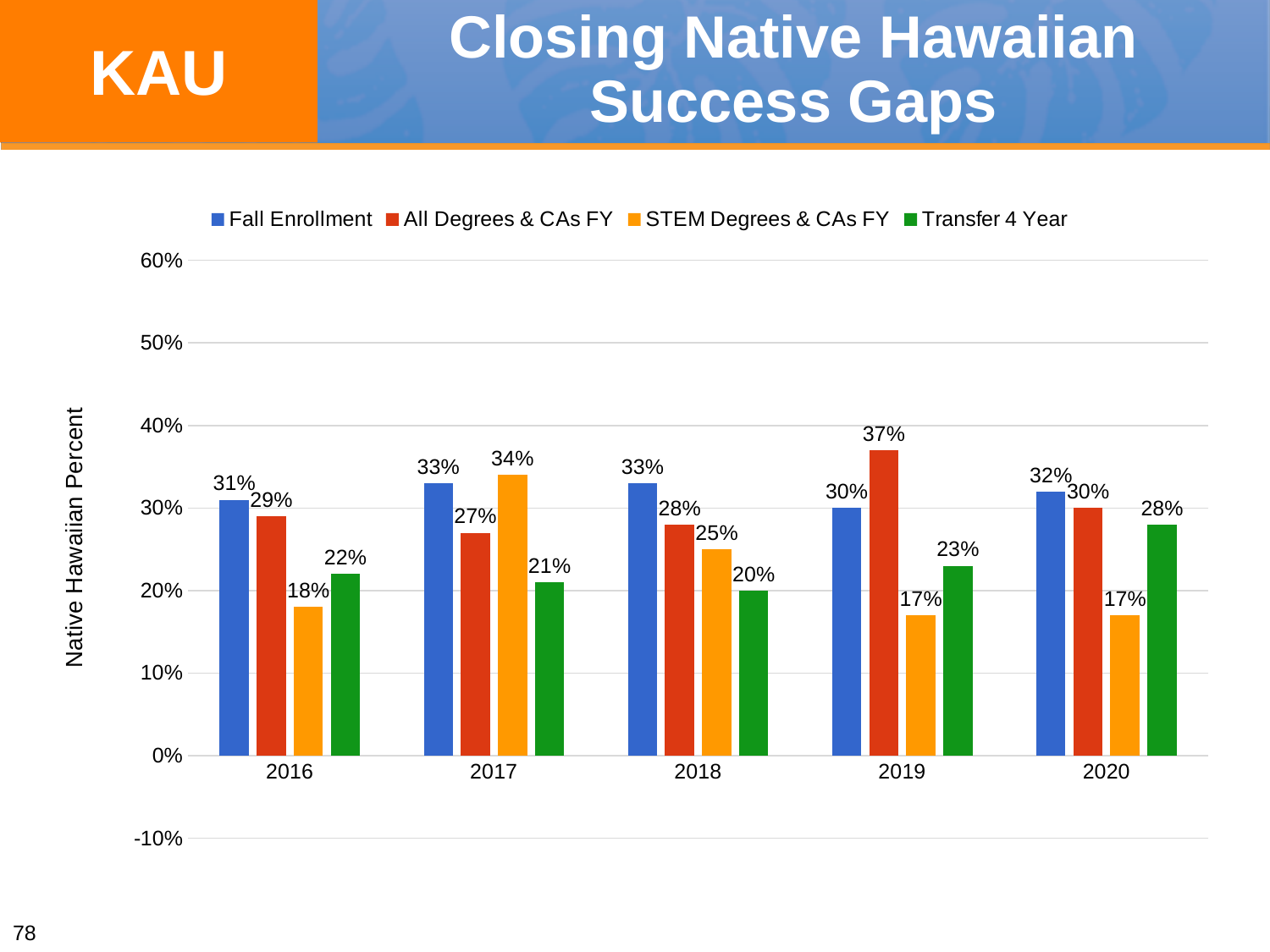
In which year is the All Degrees & CAs FY value highest? 2019 What is the Fall Enrollment value for 2016? 31% How many years are shown on the x axis? 5 What is the STEM Degrees & CAs FY value for 2017? 34% What is the Transfer 4 Year value for 2020? 28% What is the label on the vertical axis? Native Hawaiian Percent What is the All Degrees & CAs FY value for 2019? 37% What kind of chart is shown on the slide? Bar chart In which year is the Transfer 4 Year value lowest? 2018 How many series does the legend list? 4 What is the difference between the All Degrees & CAs FY value and the STEM Degrees & CAs FY value in 2019? 20% In 2017, which is larger: Fall Enrollment or STEM Degrees & CAs FY? STEM Degrees & CAs FY